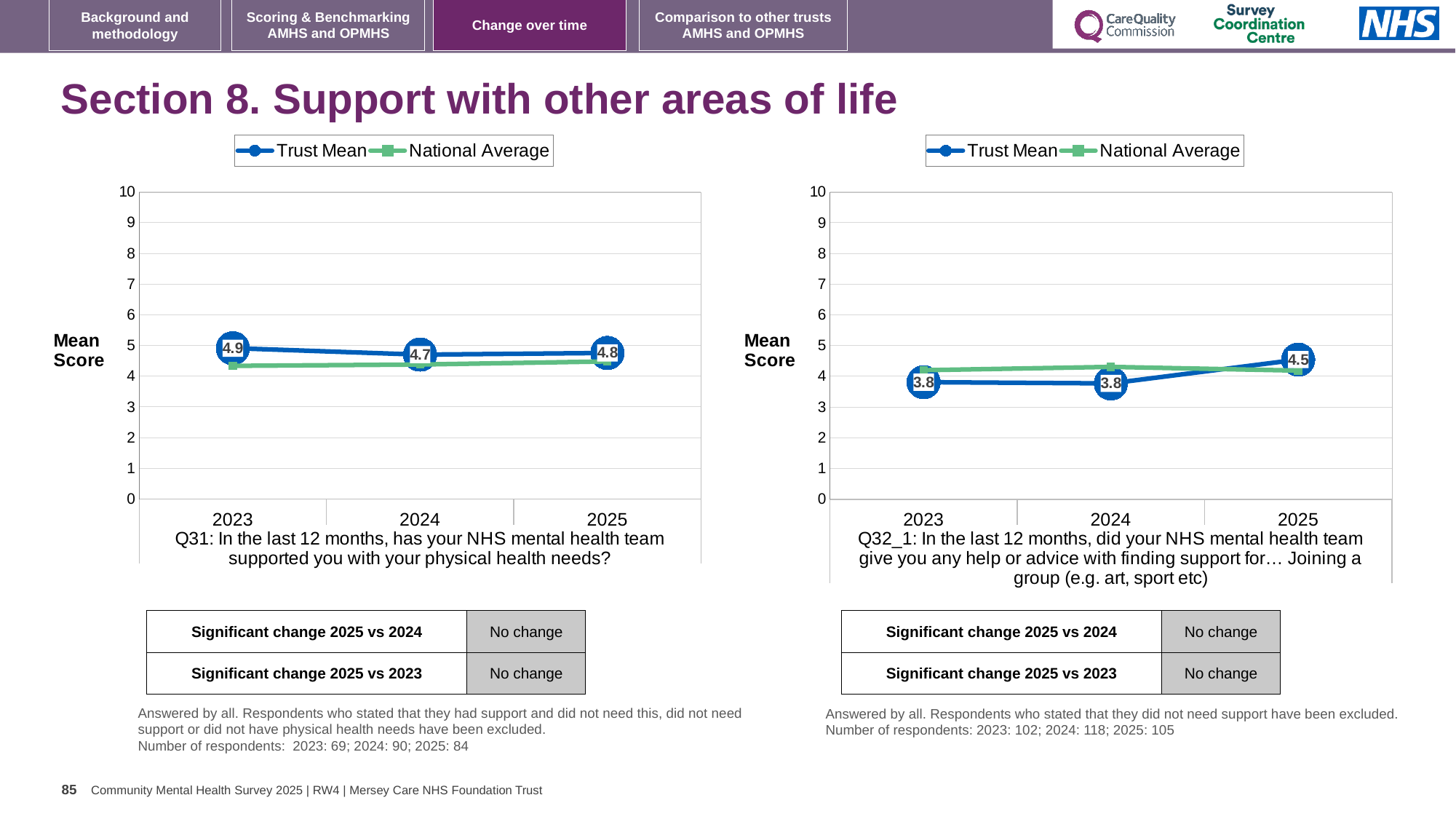
In the Q32_1 chart on the right, which year has the highest Trust Mean? 2025 In the Q31 chart on the left, which year has the lowest Trust Mean? 2024 In the Q32_1 chart on the right, what is the Trust Mean for 2025? 4.5 In the Q32_1 chart on the right, which is larger in 2025, the Trust Mean or the National Average? Trust Mean What kind of chart is the Q31 chart on the left? Line chart In the Q31 chart on the left, which year has the highest Trust Mean? 2023 In the Q31 chart on the left, what is the Trust Mean for 2023? 4.9 How many series does the legend of the Q32_1 chart on the right list? 2 In the Q31 chart on the left, what is the Trust Mean for 2024? 4.7 In the Q31 chart on the left, what is the difference between the Trust Mean for 2023 and the Trust Mean for 2024? 0.2 In the Q32_1 chart on the right, what is the difference between the Trust Mean for 2025 and the Trust Mean for 2023? 0.7 In the Q31 chart on the left, is the National Average for 2023 greater or less than 5? less